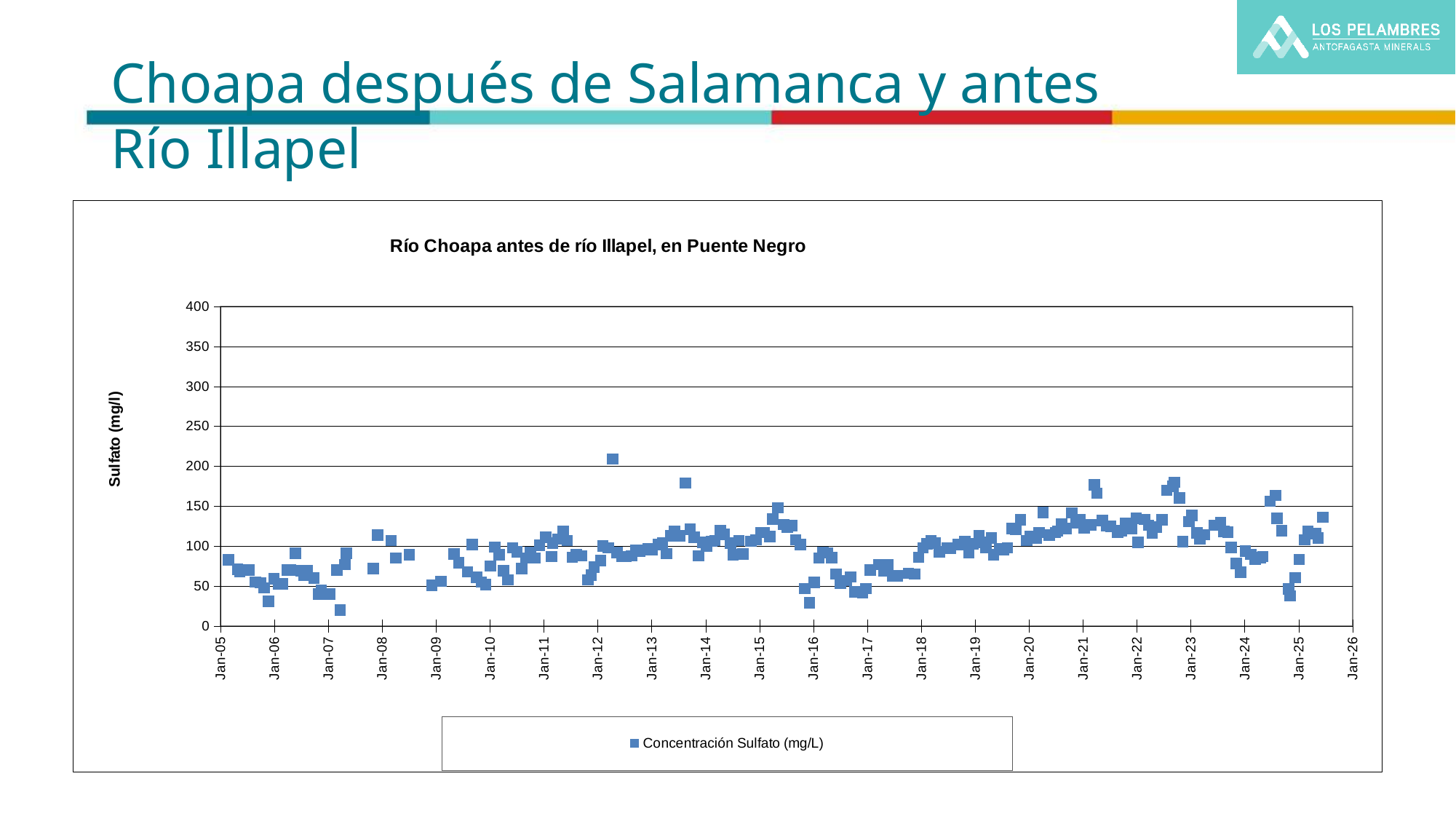
Is the highest plotted sulfate value greater or less than 250? less Is the highest point plotted in 2023 greater or less than 150? less Is the highest plotted sulfate value greater or less than 200? greater What is the legend entry for the plotted series? Concentración Sulfato (mg/L) In which year does the lowest sulfate concentration point occur? 2007 How many series does the legend list? 1 What kind of chart is shown on the slide? scatter chart What is the title of the chart? Río Choapa antes de río Illapel, en Puente Negro In which year does the highest sulfate concentration point occur? 2012